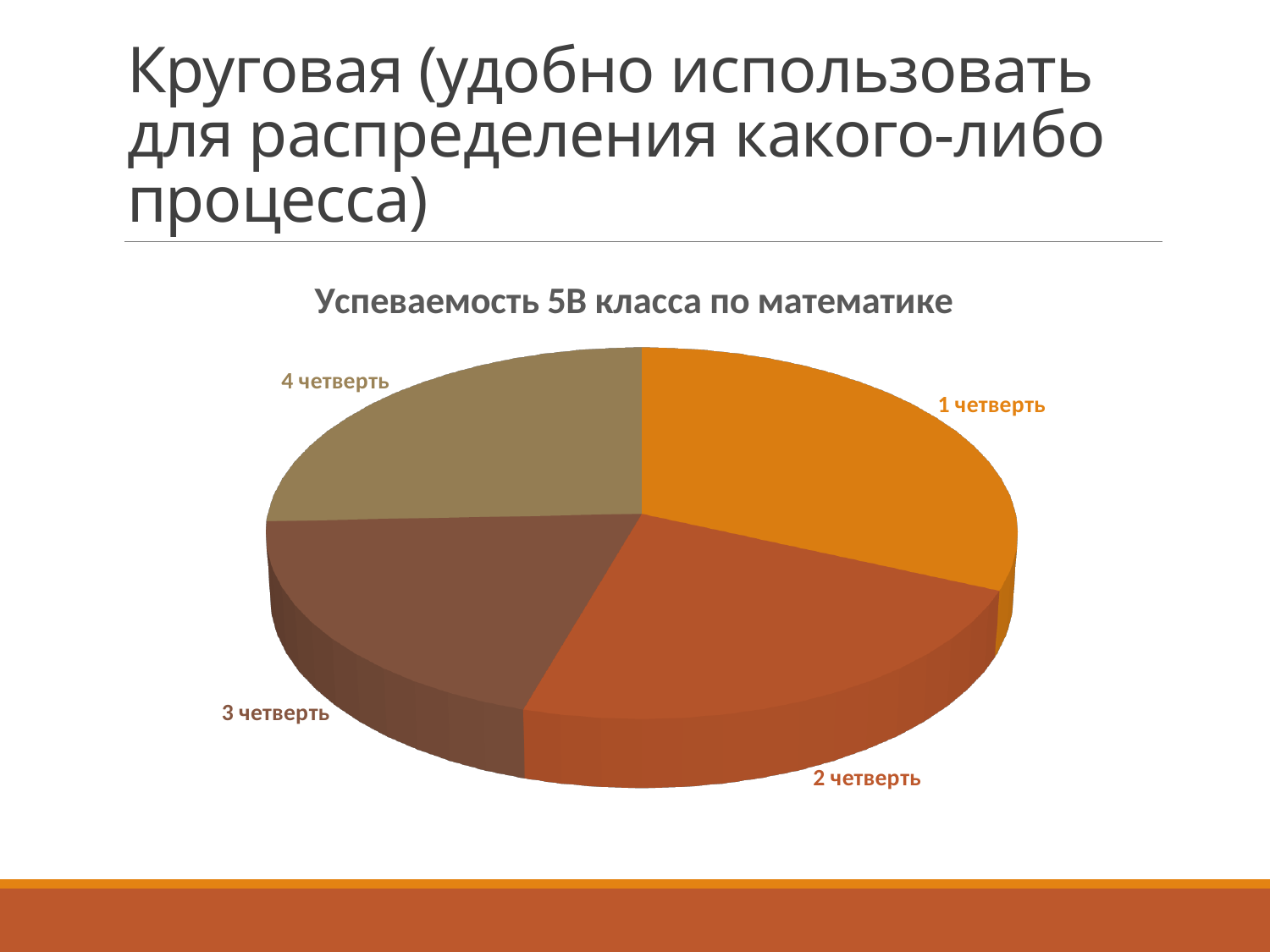
Which slice is larger, 1 четверть or 3 четверть? 1 четверть What is the title of the chart? Успеваемость 5В класса по математике Which slice of the pie chart is the largest? 1 четверть What kind of chart is shown on the slide? pie chart What colour is the slice for 1 четверть? orange How many slices does the pie chart have? 4